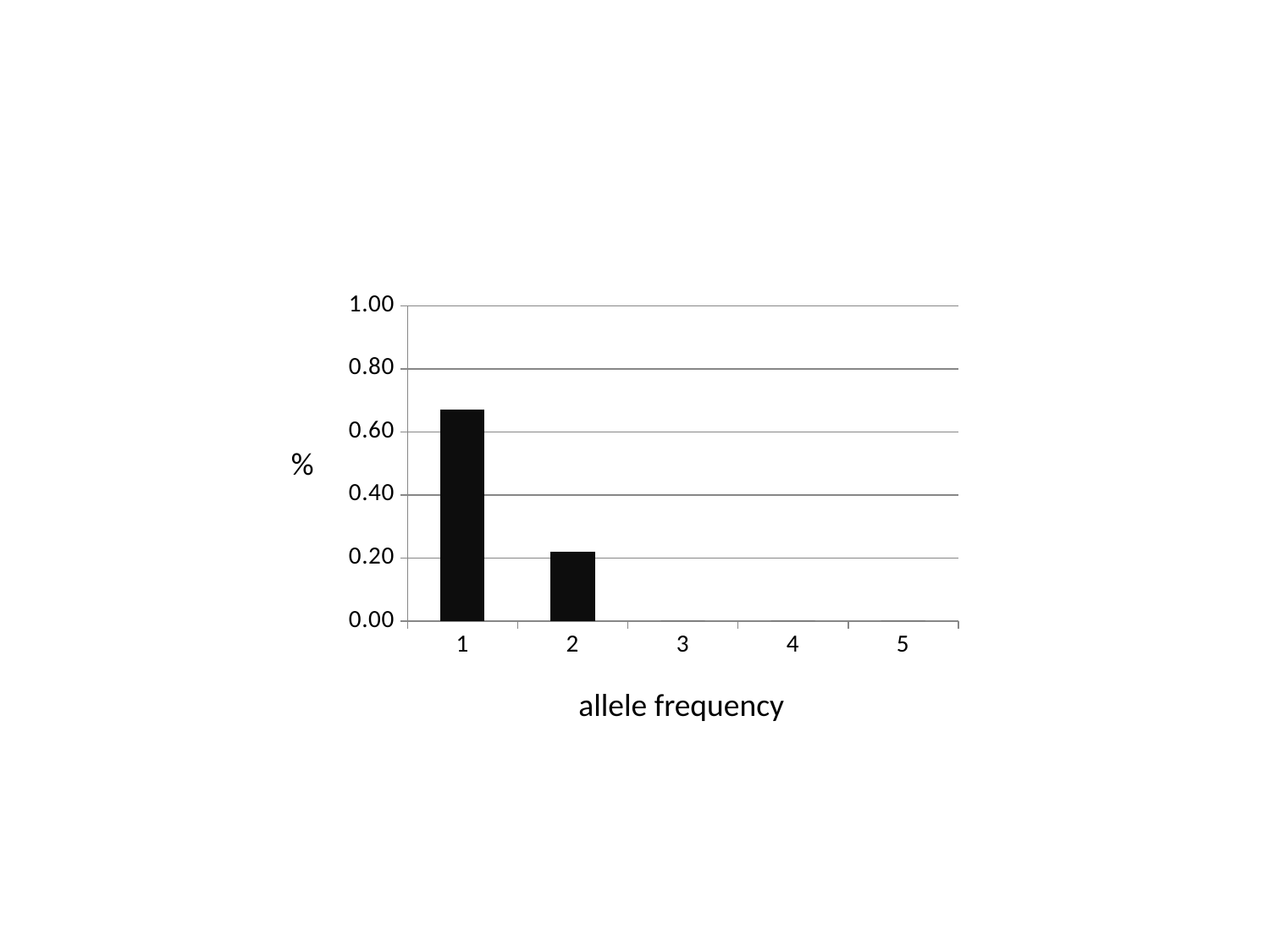
What is the label on the x axis of the chart? allele frequency How many categories are shown on the x axis of the chart? 5 What is the label on the y axis of the chart? % Is the value for allele frequency 1 greater or less than 0.60? greater Which is larger, the value for allele frequency 1 or allele frequency 2? 1 Do the values rise or fall as allele frequency increases from 1 to 2? fall Is the value for allele frequency 2 greater or less than 0.40? less What kind of chart is shown on the slide? bar chart Which allele frequency category has the highest value? 1 Is the value for allele frequency 1 greater or less than 0.80? less